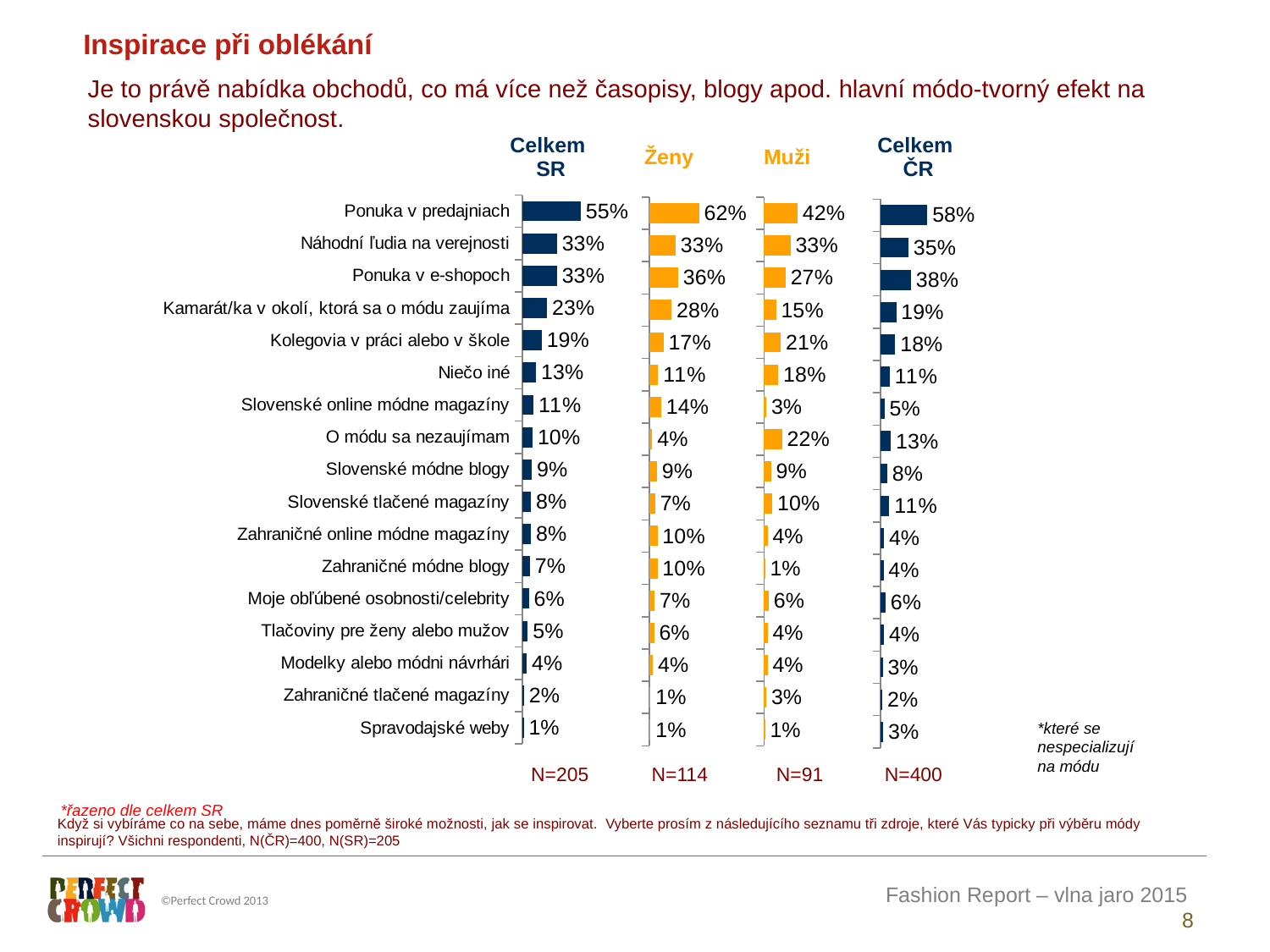
In the Muži chart, which category has the highest value? Ponuka v predajniach How many categories are listed in the Celkem SR chart? 17 What kind of chart is used for the Celkem SR data? Bar chart In the Celkem SR chart, what is the value for Ponuka v predajniach? 55% What is the difference between the Ženy and Muži values for Ponuka v predajniach? 20 percentage points In the Celkem ČR chart, which category has the lowest value? Zahraničné tlačené magazíny In the Celkem ČR chart, what is the value for Kamarát/ka v okolí, ktorá sa o módu zaujíma? 19% In the Muži chart, what is the value for O módu sa nezaujímam? 22% What is the sample size (N) shown under the Muži chart? N=91 In the Ženy chart, what is the value for Ponuka v e-shopoch? 36% What is the difference between the Celkem ČR and Celkem SR values for Ponuka v e-shopoch? 5 percentage points Which is larger for Slovenské online módne magazíny: the Ženy value or the Muži value? Ženy